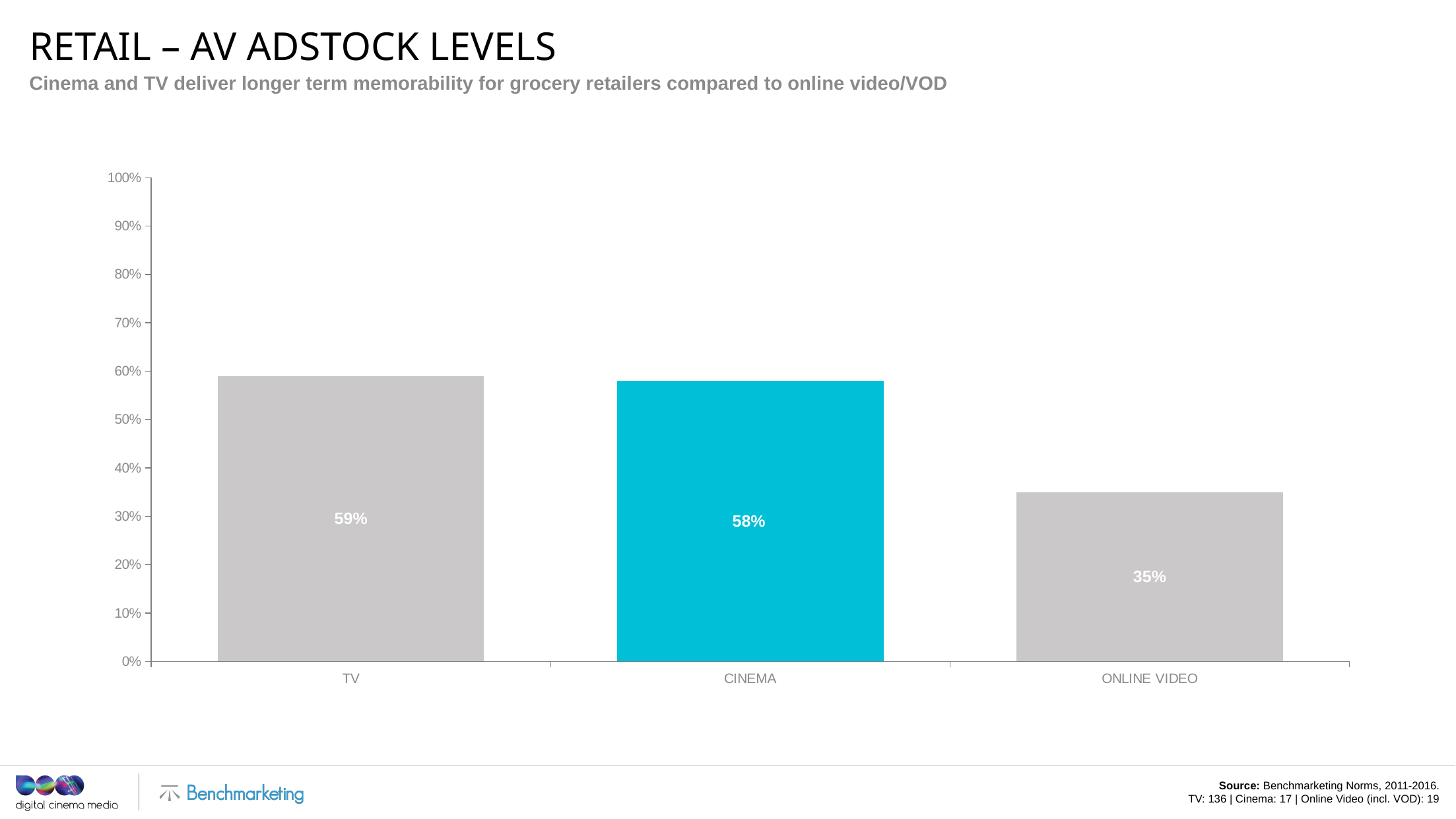
What is the difference between the CINEMA and ONLINE VIDEO adstock levels? 23% What is the adstock level for CINEMA? 58% What is the adstock level for ONLINE VIDEO? 35% Is the value for ONLINE VIDEO greater or less than 40%? less Which is larger, the value for CINEMA or the value for ONLINE VIDEO? CINEMA Which bar is highlighted in a different colour (blue) from the others? CINEMA Which category has the lowest adstock level? ONLINE VIDEO Is the value for TV greater or less than 50%? greater What is the adstock level for TV? 59% What is the difference between the TV and ONLINE VIDEO adstock levels? 24% How many categories are shown on the chart? 3 What kind of chart is shown on the slide? bar chart